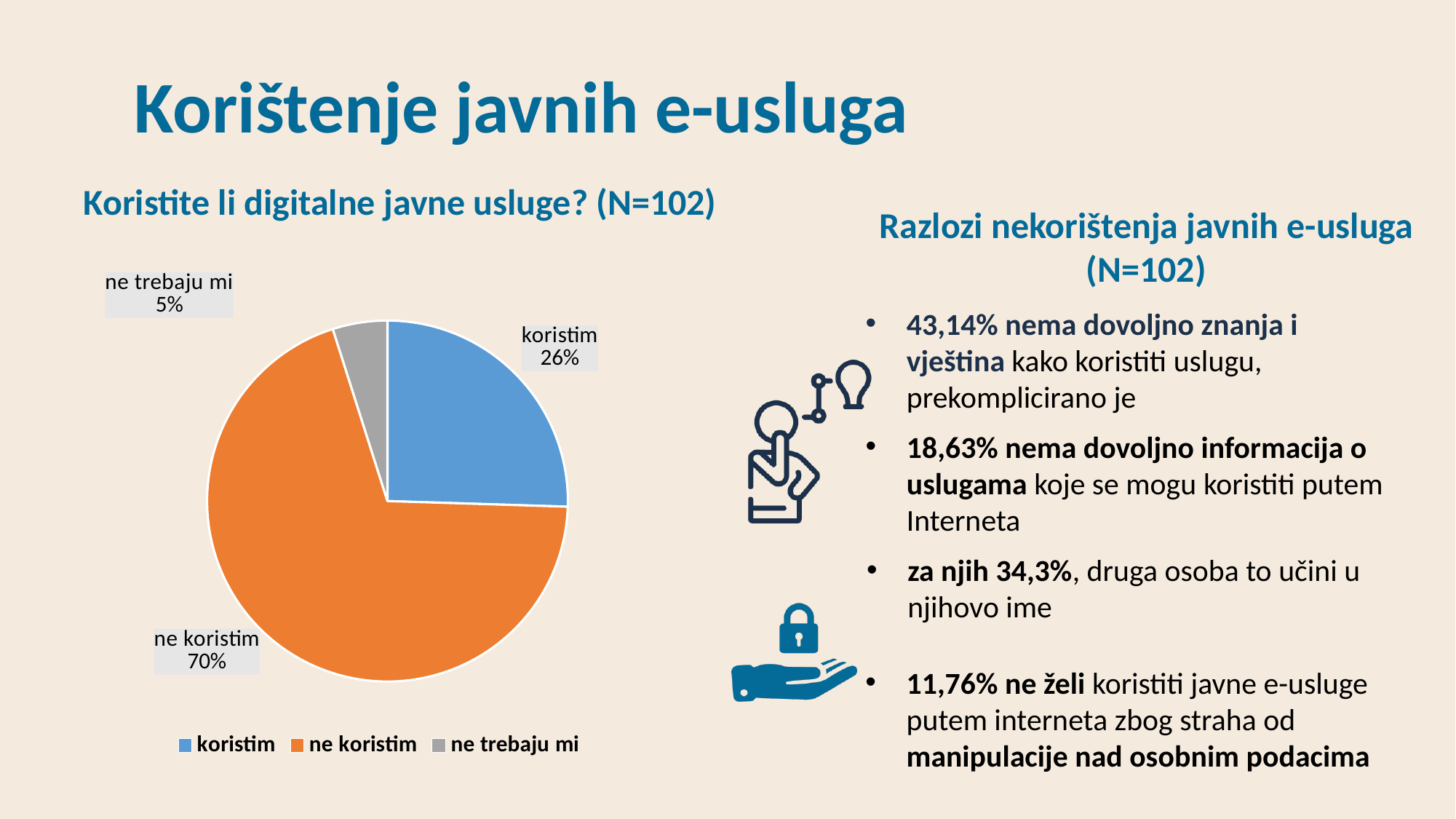
What percentage of respondents answered "koristim"? 26% Which category has the largest slice of the pie? ne koristim What percentage of respondents answered "ne koristim"? 70% What colour is the "ne koristim" slice? orange What is the title of the pie chart? Koristite li digitalne javne usluge? (N=102) What percentage of respondents answered "ne trebaju mi"? 5% Which is larger, the share for "koristim" or the share for "ne trebaju mi"? koristim How many categories does the pie chart show? 3 What is the difference in percentage points between "ne koristim" and "koristim"? 44 What kind of chart is shown on the slide? pie chart How many entries does the legend list? 3 Which category has the smallest slice of the pie? ne trebaju mi